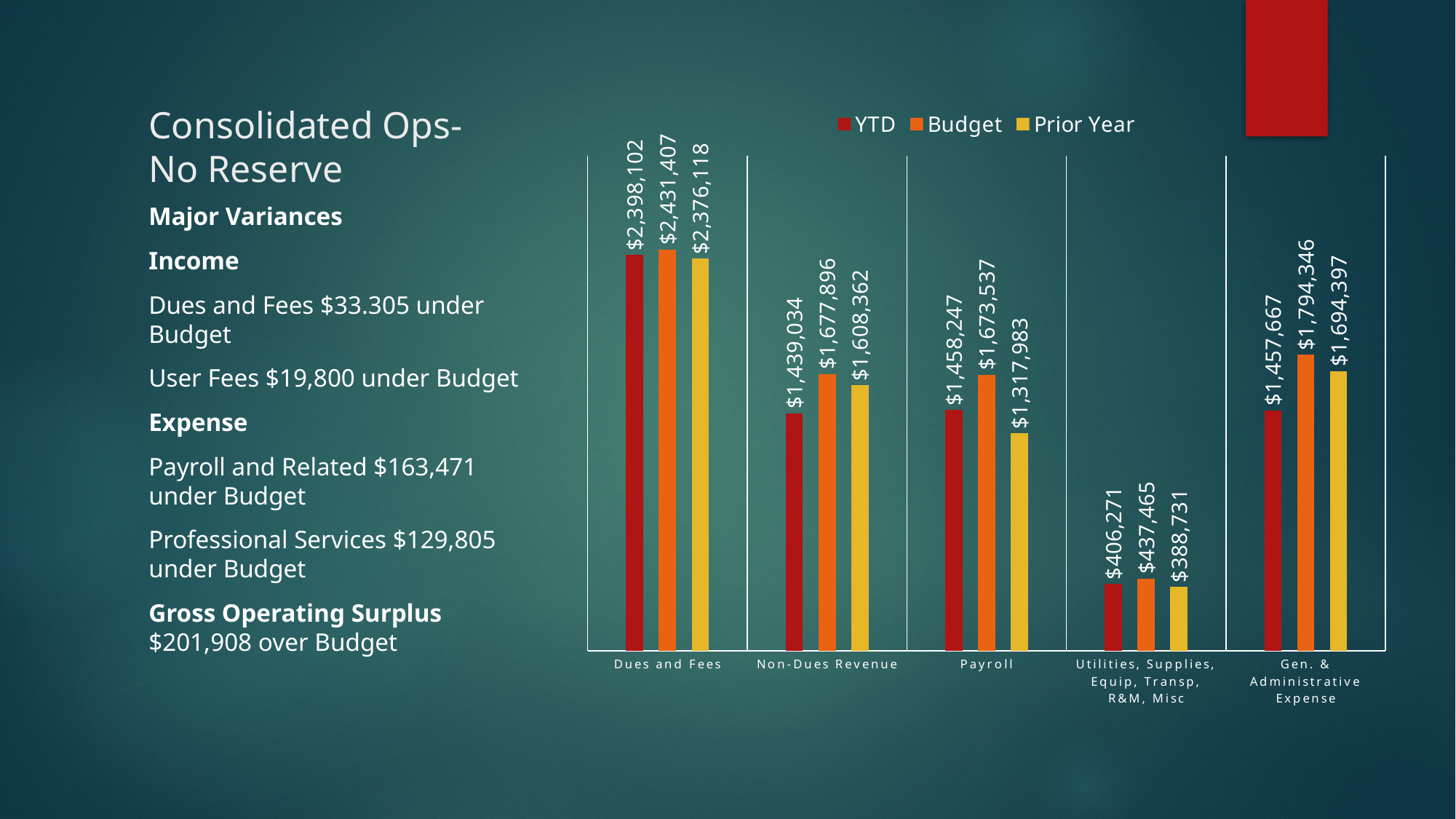
What is the YTD value for Dues and Fees? $2,398,102 Which category has the lowest Prior Year value? Utilities, Supplies, Equip, Transp, R&M, Misc What kind of chart is shown on the slide? Bar chart What is the Budget value for Payroll? $1,673,537 What is the difference between the Budget and YTD values for Dues and Fees? $33,305 For Payroll, which is larger: the Budget value or the Prior Year value? Budget What is the Budget value for Utilities, Supplies, Equip, Transp, R&M, Misc? $437,465 How many series does the chart legend list? 3 What is the Prior Year value for Gen. & Administrative Expense? $1,694,397 How many categories are shown on the x axis of the chart? 5 What is the difference between the Budget and YTD values for Payroll? $215,290 Which category has the highest YTD value? Dues and Fees